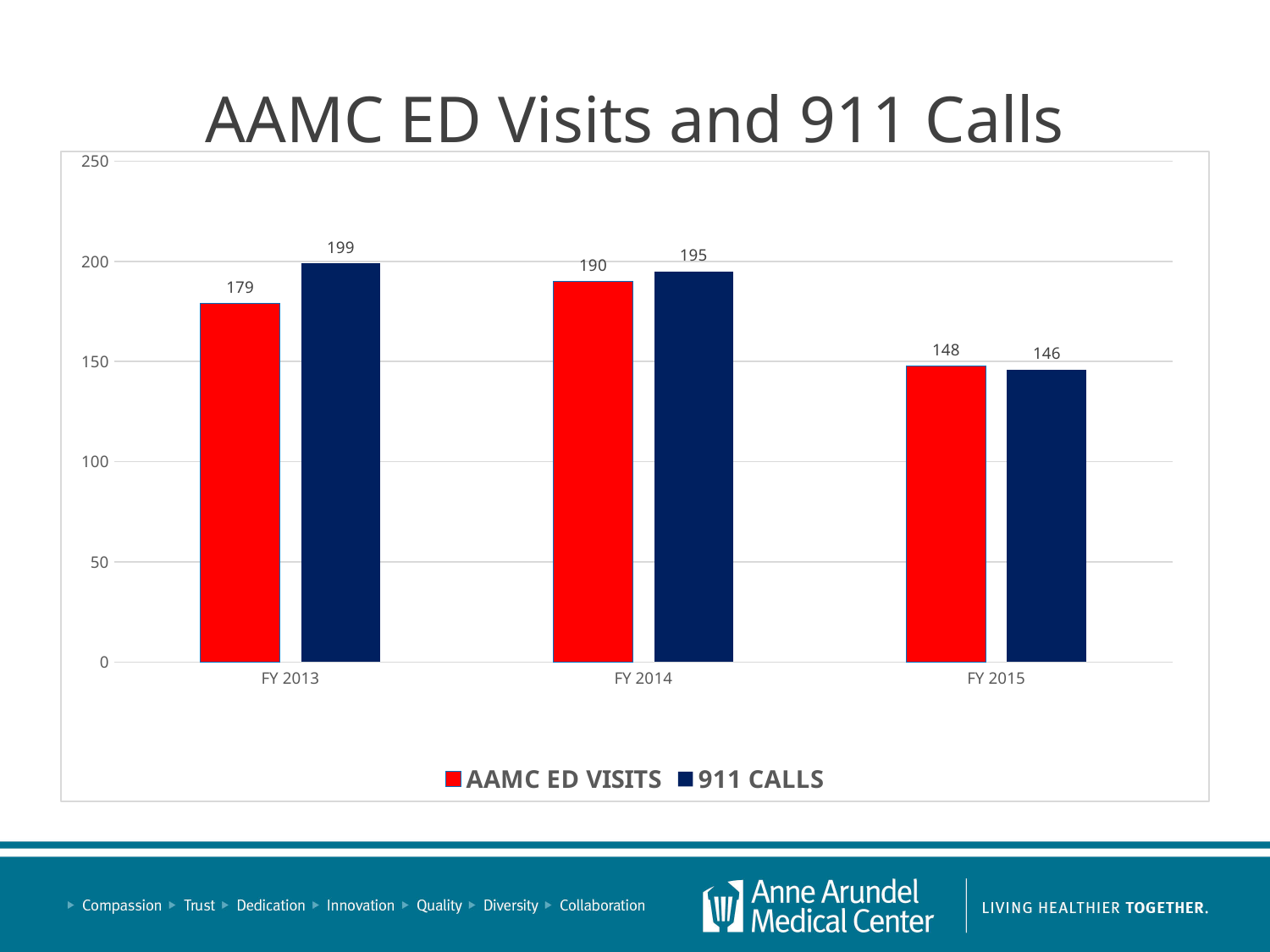
What is the value of 911 CALLS for FY 2014? 195 What is the value of 911 CALLS for FY 2015? 146 Which fiscal year has the highest value for 911 CALLS? FY 2013 What is the difference in AAMC ED VISITS between FY 2014 and FY 2015? 42 What is the difference between 911 CALLS and AAMC ED VISITS in FY 2013? 20 How many fiscal years are shown on the x axis? 3 What kind of chart is shown on the slide? Bar chart Which fiscal year has the lowest value for AAMC ED VISITS? FY 2015 What is the value of AAMC ED VISITS for FY 2013? 179 Which is larger in FY 2014: AAMC ED VISITS or 911 CALLS? 911 CALLS How many series does the legend list? 2 What is the title of the chart? AAMC ED Visits and 911 Calls